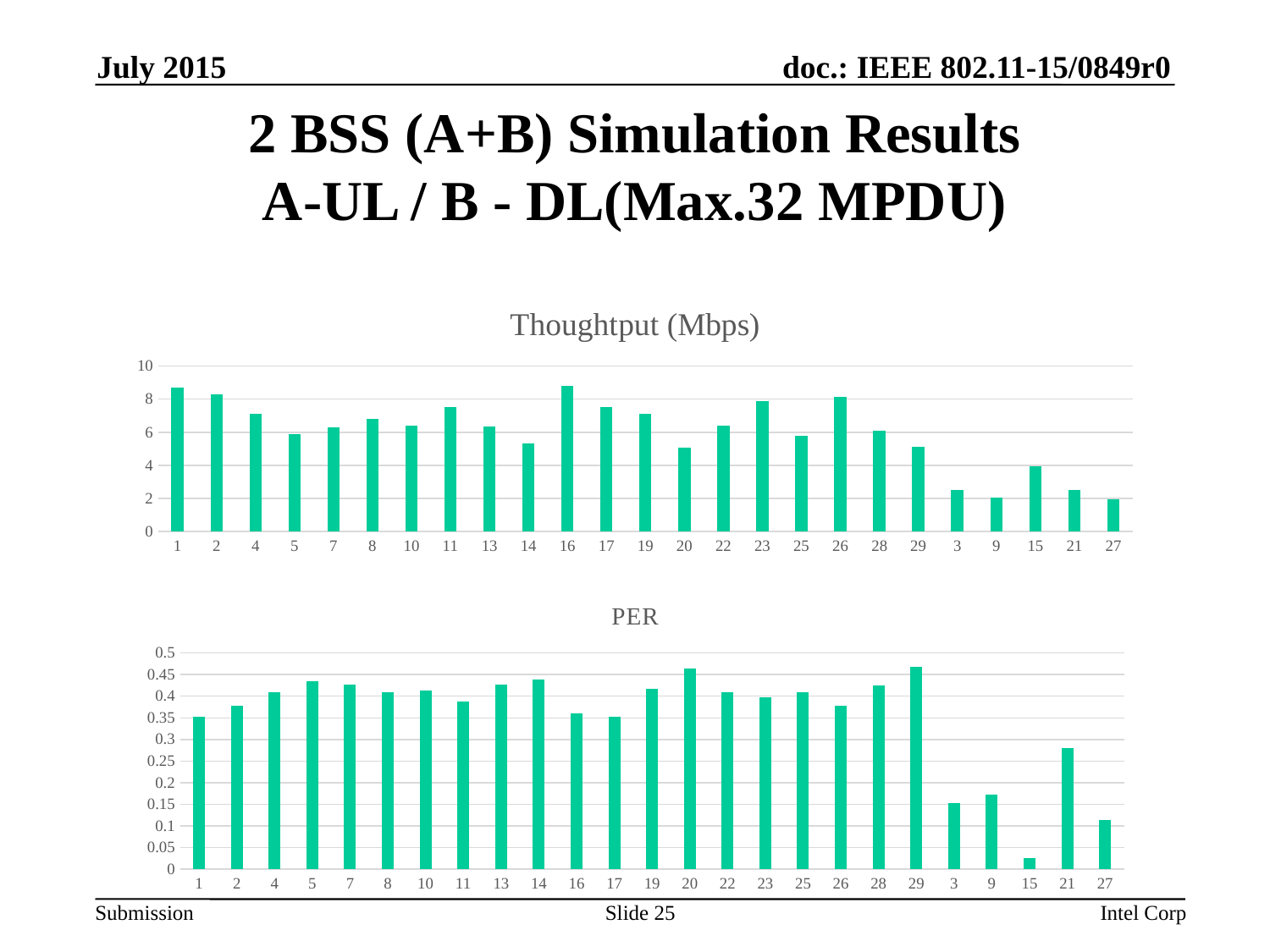
What is the title of the top chart on the slide? Thoughtput (Mbps) On the PER chart, which category has the lowest value? 15 On the Thoughtput (Mbps) chart, is the value for category 3 greater or less than 4? less On the PER chart, is the value for category 3 greater or less than 0.2? less On the Thoughtput (Mbps) chart, is the value for category 1 greater or less than 8? greater What kind of chart is the Thoughtput (Mbps) chart? bar chart On the PER chart, which has the larger value, category 5 or category 15? 5 On the Thoughtput (Mbps) chart, which has the larger value, category 1 or category 3? 1 How many categories are plotted on the PER chart? 25